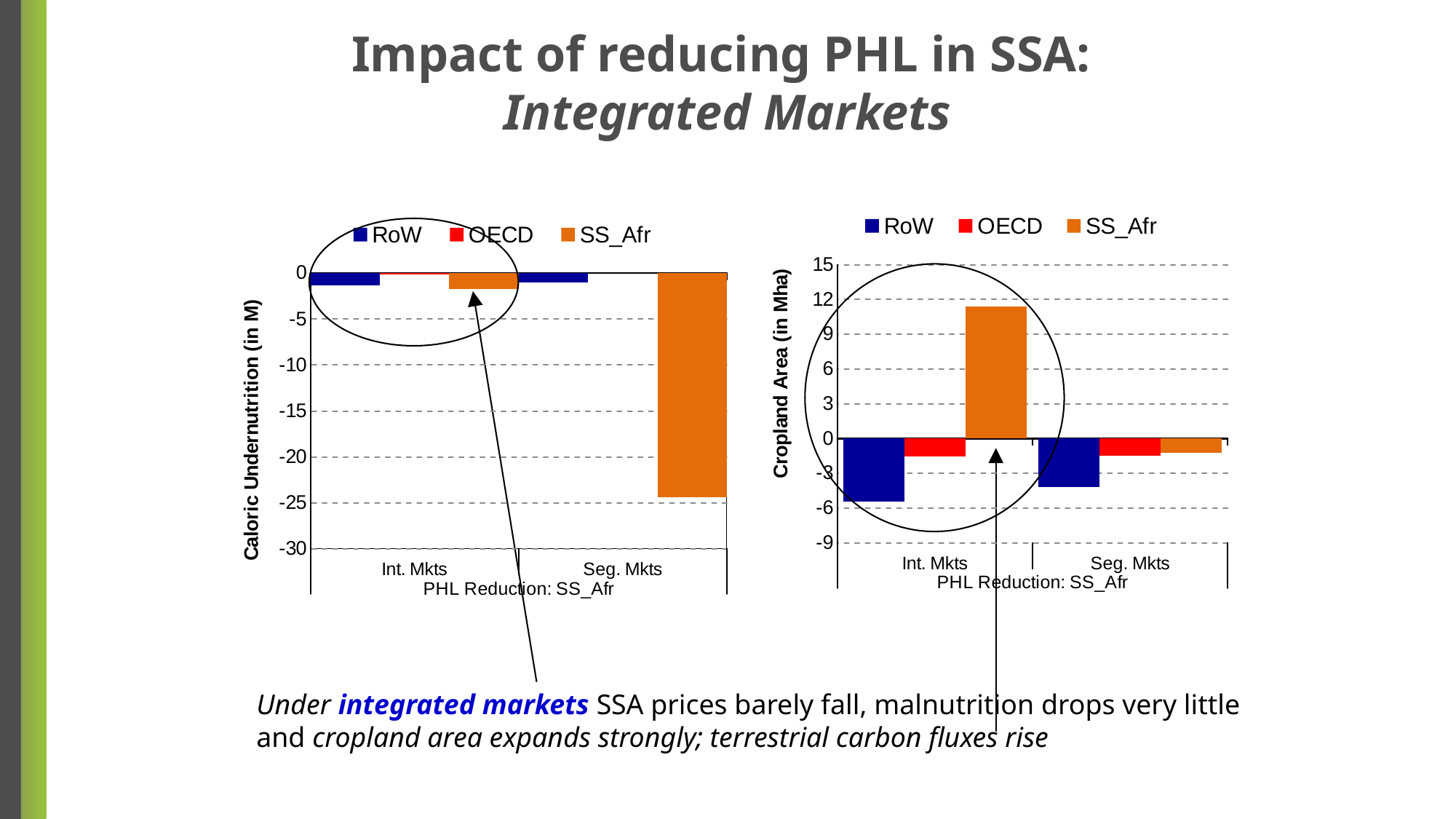
In the left chart (Caloric Undernutrition), is the value for SS_Afr under Seg. Mkts greater or less than -20? less What is the y-axis title of the left chart? Caloric Undernutrition (in M) Which colour represents SS_Afr in the legend of the right chart (Cropland Area)? orange In the right chart (Cropland Area), is the value for RoW under Int. Mkts greater or less than -3? less In the right chart (Cropland Area), which bar extends furthest below zero? RoW, Int. Mkts In the right chart (Cropland Area), which bar is the highest? SS_Afr, Int. Mkts How many categories are shown on the x axis of the left chart (Caloric Undernutrition)? 2 In the right chart (Cropland Area), which has the larger value for SS_Afr: Int. Mkts or Seg. Mkts? Int. Mkts In the left chart (Caloric Undernutrition), which bar extends furthest below zero? SS_Afr, Seg. Mkts What kind of chart is the left chart (Caloric Undernutrition)? bar chart In the right chart (Cropland Area), is the value for SS_Afr under Int. Mkts greater or less than 9? greater How many series does the legend of the right chart (Cropland Area) list? 3